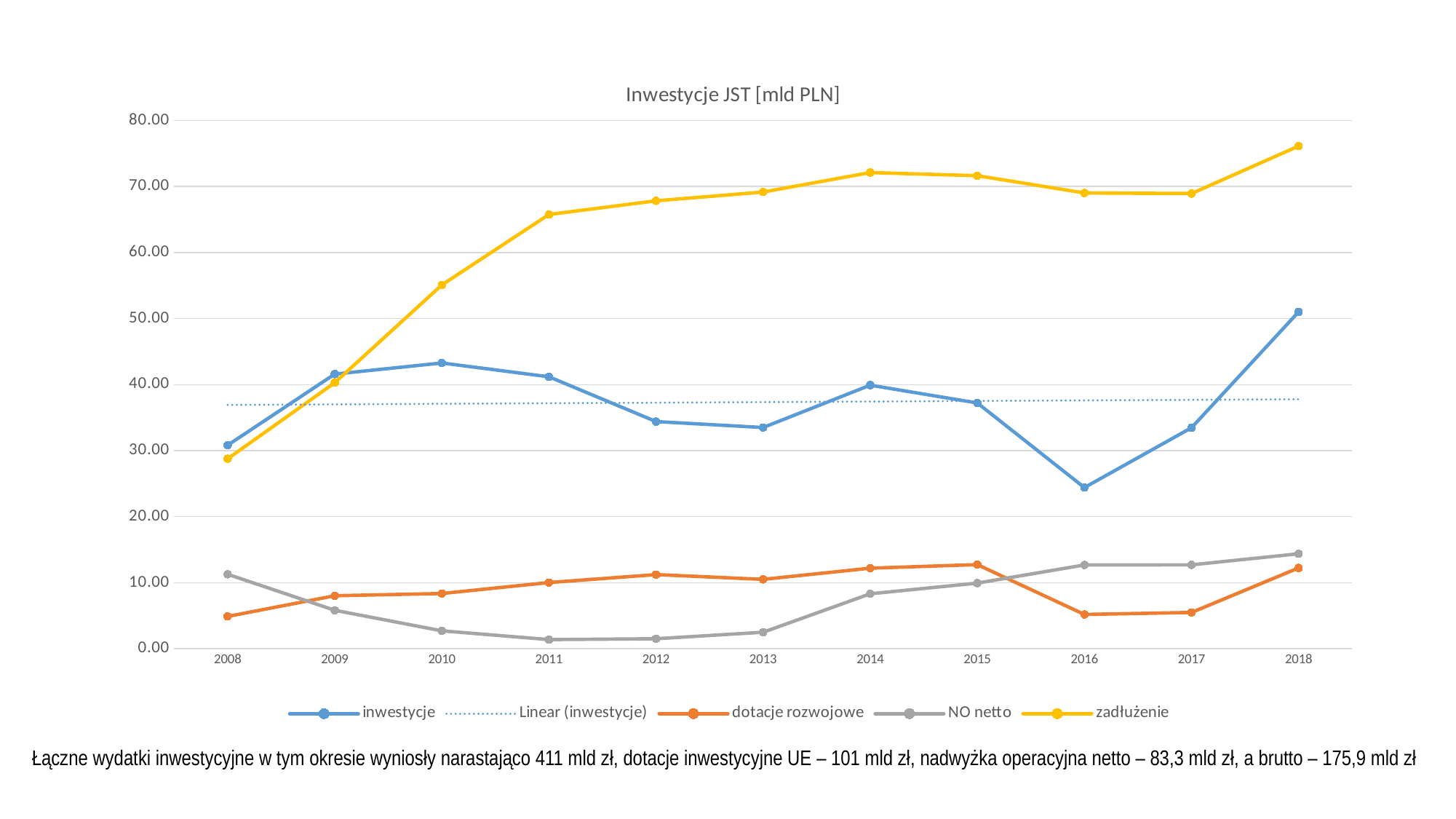
In which year does the inwestycje series reach its lowest value? 2016 In 2010, which is larger: inwestycje or zadłużenie? zadłużenie Is the value for inwestycje in 2016 greater or less than 30.00? less Is the value for zadłużenie in 2018 greater or less than 70.00? greater Is the value for inwestycje in 2018 greater or less than 40.00? greater In 2016, which is larger: dotacje rozwojowe or NO netto? NO netto In which year does the zadłużenie series reach its highest value? 2018 Does the zadłużenie series rise or fall from 2008 to 2014? rise How many series does the legend list? 5 How many years are shown on the x axis? 11 What is the title of the chart? Inwestycje JST [mld PLN] What kind of chart is shown on the slide? line chart